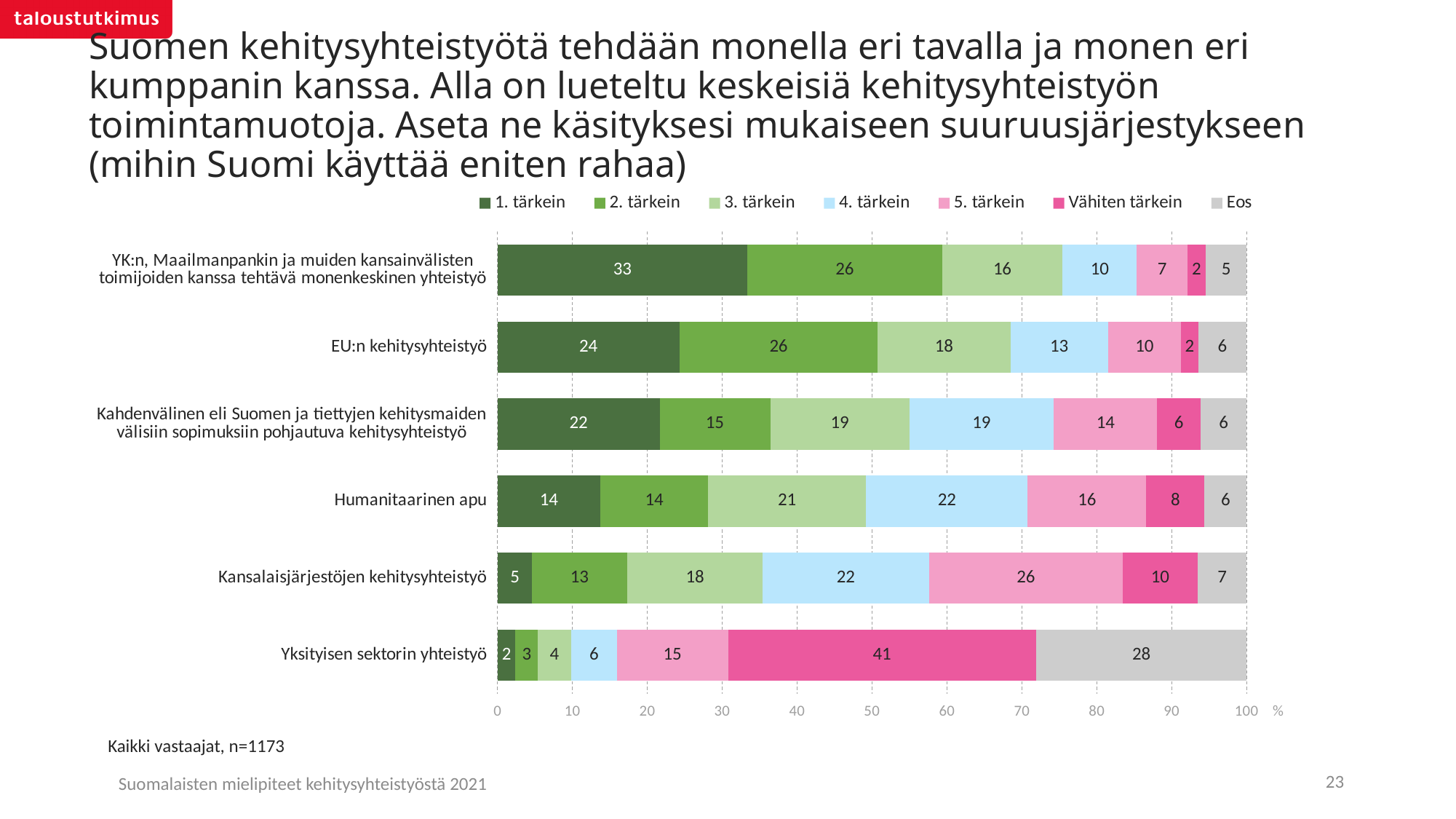
Which category has the highest value for "Eos"? Yksityisen sektorin yhteistyö What is the value of "3. tärkein" for Kahdenvälinen eli Suomen ja tiettyjen kehitysmaiden välisiin sopimuksiin pohjautuva kehitysyhteistyö? 19 For Humanitaarinen apu, what is the difference between the "4. tärkein" value and the "1. tärkein" value? 8 How many series does the legend list? 7 Which has the larger "5. tärkein" value: Kansalaisjärjestöjen kehitysyhteistyö or Humanitaarinen apu? Kansalaisjärjestöjen kehitysyhteistyö How many categories are shown on the chart? 6 Which category has the highest value for "1. tärkein"? YK:n, Maailmanpankin ja muiden kansainvälisten toimijoiden kanssa tehtävä monenkeskinen yhteistyö What is the value of "Vähiten tärkein" for Yksityisen sektorin yhteistyö? 41 What is the value of "1. tärkein" for EU:n kehitysyhteistyö? 24 Which category has the lowest value for "Eos"? YK:n, Maailmanpankin ja muiden kansainvälisten toimijoiden kanssa tehtävä monenkeskinen yhteistyö What is the value of "Eos" for Yksityisen sektorin yhteistyö? 28 What kind of chart is shown on the slide? Stacked bar chart